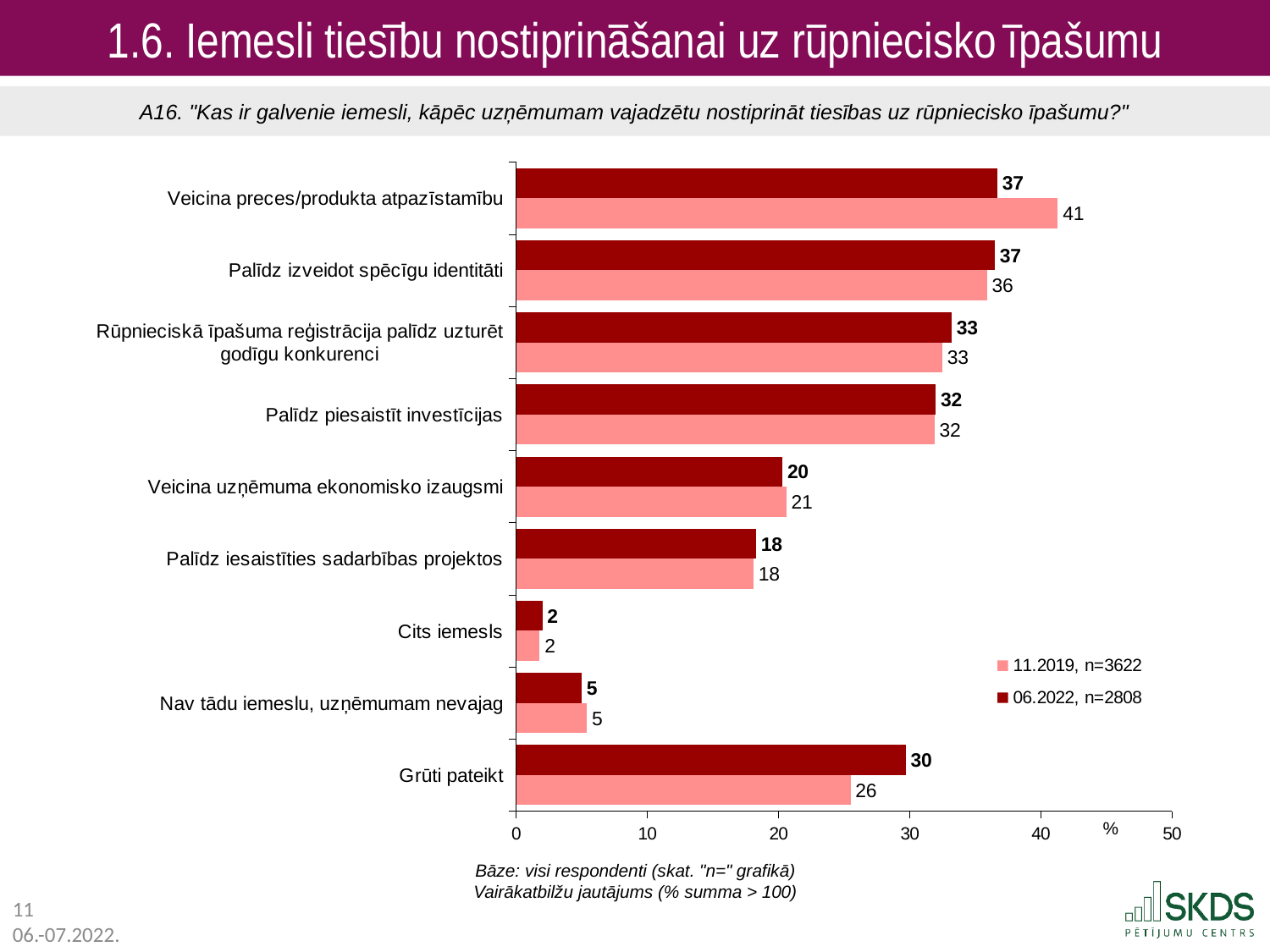
Which category has the lowest value in the 06.2022, n=2808 series? Cits iemesls For "Palīdz izveidot spēcīgu identitāti", which series has the larger value, 11.2019 or 06.2022? 06.2022 What is the value for "Grūti pateikt" in the 06.2022, n=2808 series? 30 What kind of chart is shown on the slide? Bar chart Which category has the highest value in the 11.2019, n=3622 series? Veicina preces/produkta atpazīstamību What is the difference between the 11.2019 and 06.2022 values for "Veicina preces/produkta atpazīstamību"? 4 What is the sample size (n) for the 06.2022 series shown in the legend? 2808 How many categories are shown on the chart? 9 What is the value for "Palīdz piesaistīt investīcijas" in the 06.2022, n=2808 series? 32 What is the difference between the 06.2022 and 11.2019 values for "Grūti pateikt"? 4 How many series does the legend list? 2 What is the value for "Veicina preces/produkta atpazīstamību" in the 11.2019, n=3622 series? 41